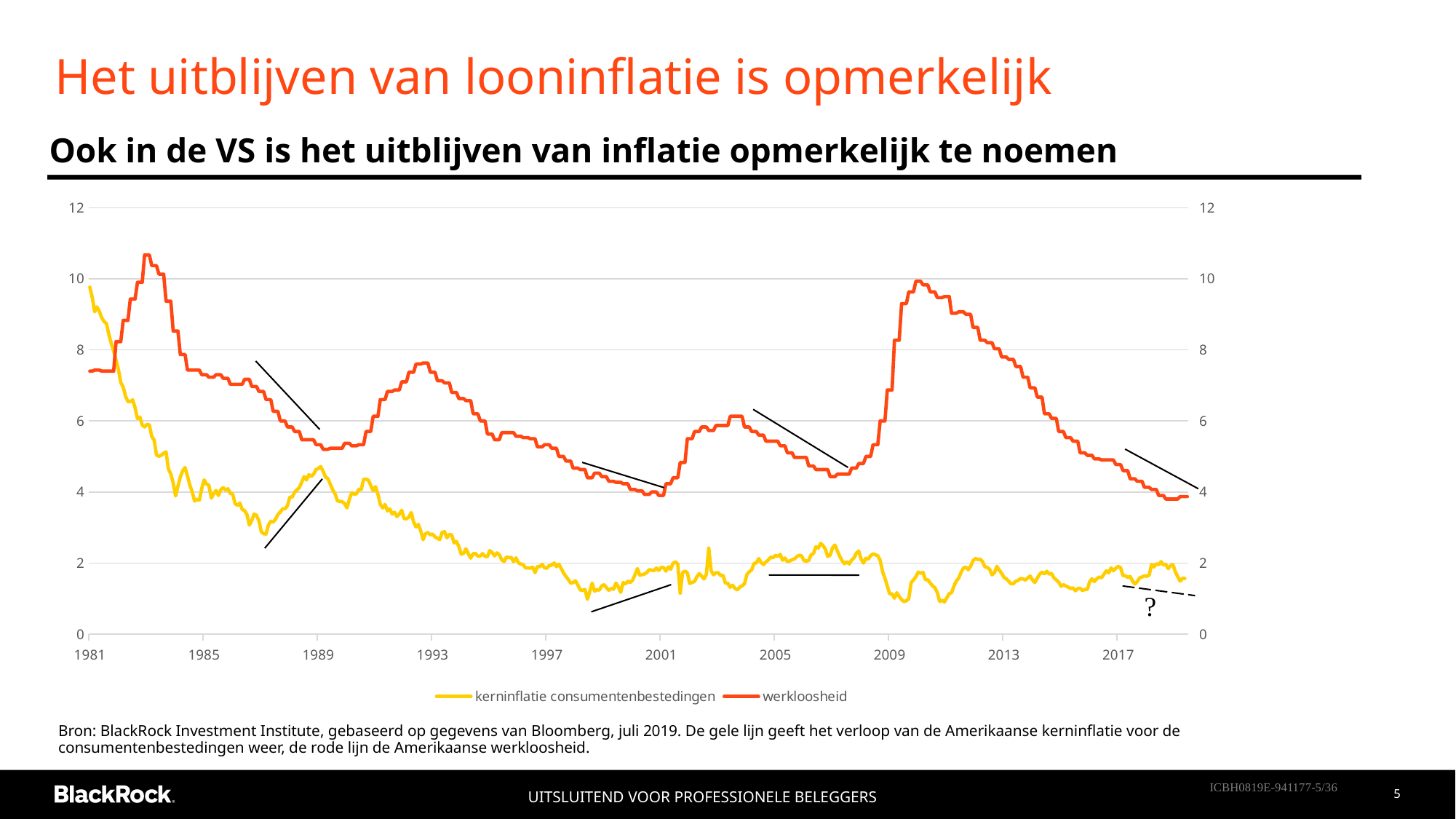
How many series does the legend list? 2 Is the value for werkloosheid at its peak around 1983 greater or less than 10? greater Is the value for werkloosheid in 2001 greater or less than 6? less In 2009, which series has the higher value, werkloosheid or kerninflatie consumentenbestedingen? werkloosheid Is the value for kerninflatie consumentenbestedingen in 1981 greater or less than 8? greater Which series is drawn in red? werkloosheid Does the kerninflatie consumentenbestedingen line overall rise or fall from 1981 to the end of the chart? fall In 1981, which series has the higher value, werkloosheid or kerninflatie consumentenbestedingen? kerninflatie consumentenbestedingen What kind of chart is shown on the slide? line chart Which series is drawn in yellow? kerninflatie consumentenbestedingen